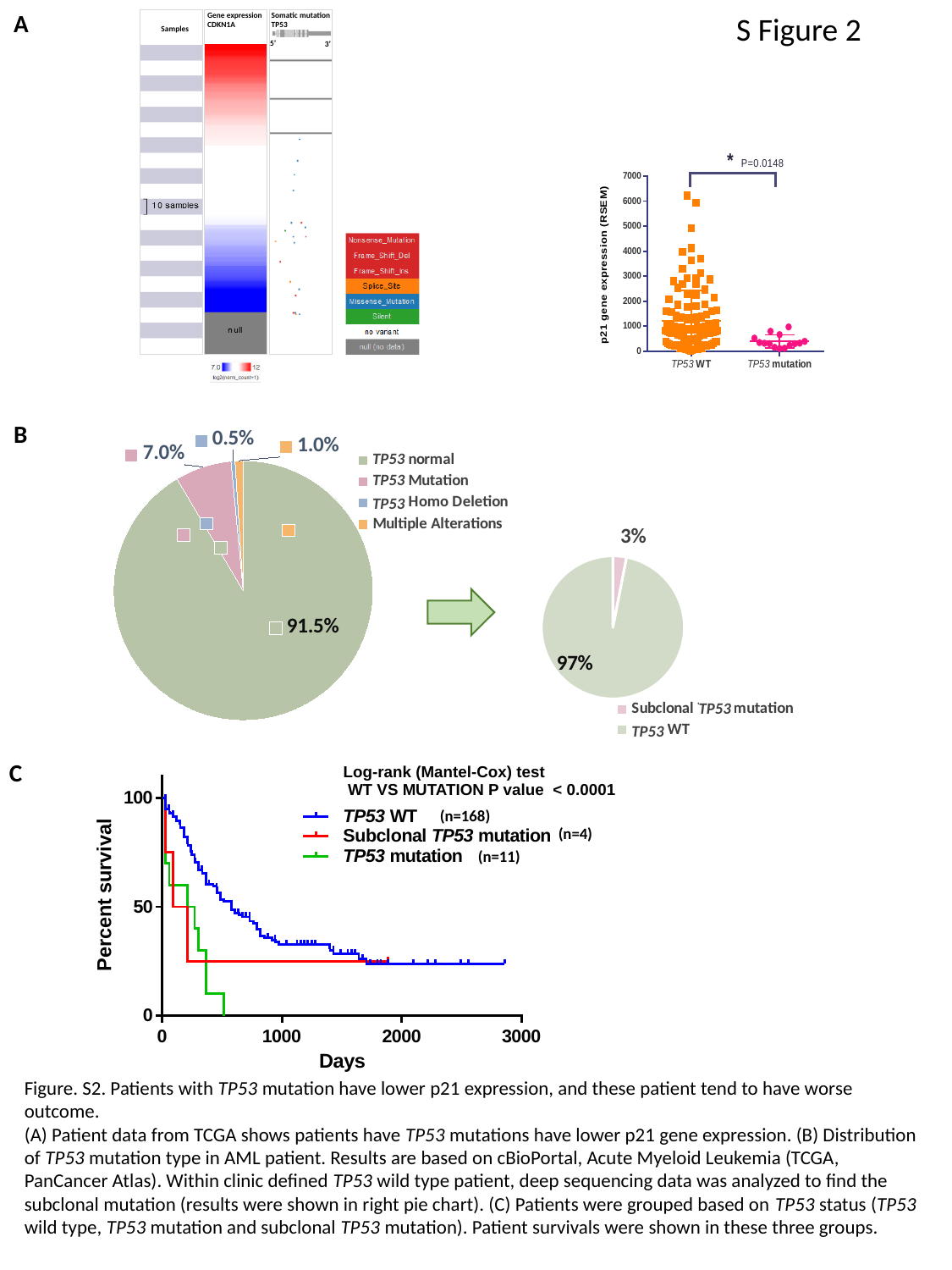
In the right pie chart of panel B, what is the difference in percentage points between TP53 WT and Subclonal TP53 mutation? 94 percentage points In the right pie chart of panel B, what share of patients has a Subclonal TP53 mutation? 3% In the left pie chart of panel B, how many slices are there? 4 In the left pie chart of panel B, which category has the smallest slice? TP53 Homo Deletion In the left pie chart of panel B, which category has the largest slice? TP53 normal In the left pie chart of panel B, what share of patients has a TP53 Homo Deletion? 0.5% In the left pie chart of panel B, what share of patients is TP53 normal? 91.5% In the survival chart of panel C, does the TP53 WT curve rise or fall as Days increase? fall In the survival chart of panel C, how many patients are in the TP53 WT group? 168 In the survival chart of panel C, how many groups does the legend list? 3 In the left pie chart of panel B, what is the difference in percentage points between TP53 Mutation and Multiple Alterations? 6.0 percentage points In the scatter plot of panel A, which group shows higher p21 gene expression, TP53 WT or TP53 mutation? TP53 WT